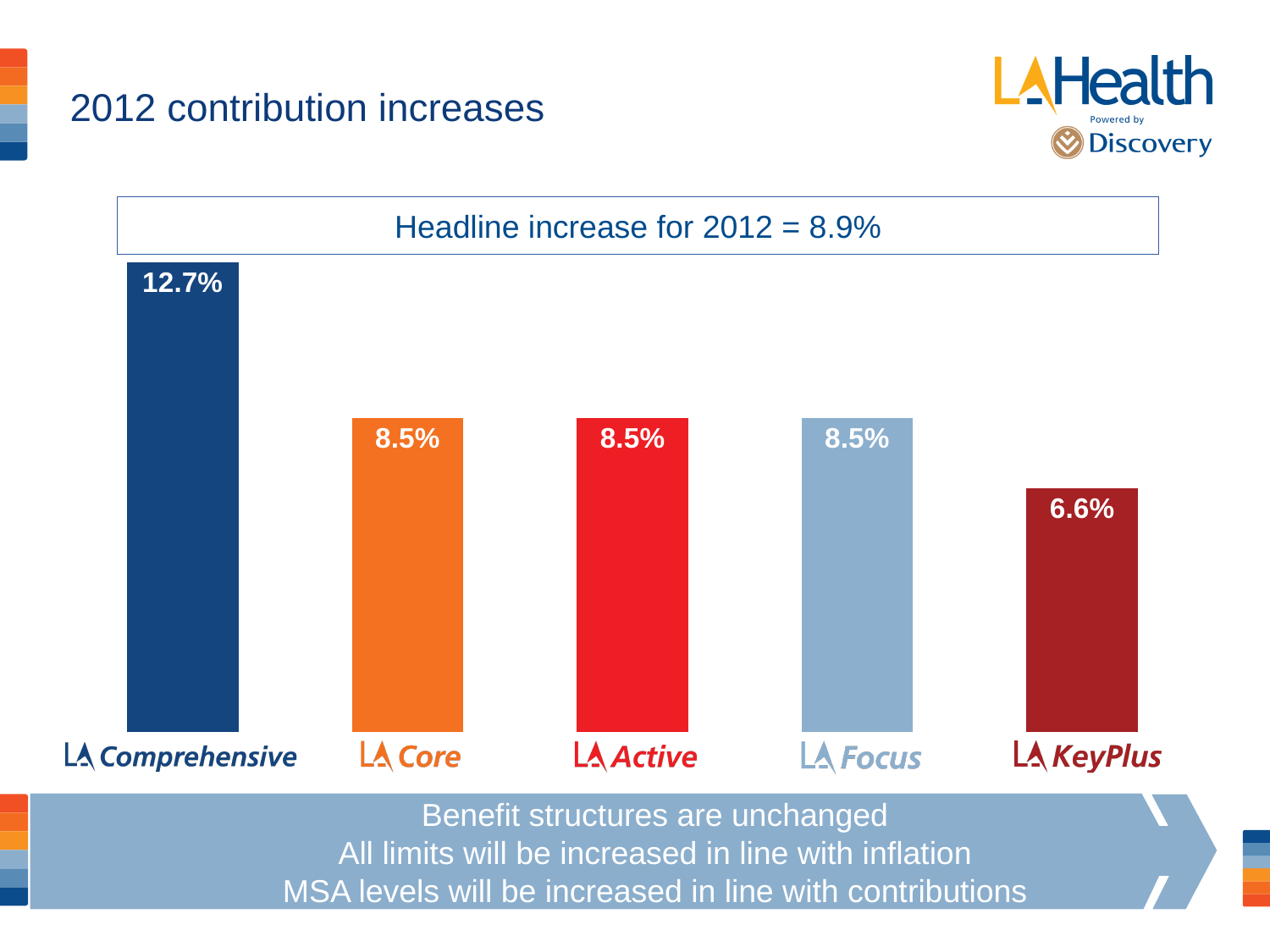
How many plans are shown in the chart? 5 Which plan has the lowest 2012 contribution increase? LA KeyPlus Which plan has the highest 2012 contribution increase? LA Comprehensive What kind of chart is shown on the slide? Bar chart What is the headline increase for 2012 stated above the chart? 8.9% What is the 2012 contribution increase for LA Focus? 8.5% What is the 2012 contribution increase for LA Core? 8.5% What is the 2012 contribution increase for LA KeyPlus? 6.6% What is the difference between the contribution increases for LA Comprehensive and LA Active? 4.2% Which has a larger contribution increase, LA Active or LA KeyPlus? LA Active What is the difference between the contribution increases for LA Comprehensive and LA KeyPlus? 6.1% What is the 2012 contribution increase for LA Comprehensive? 12.7%